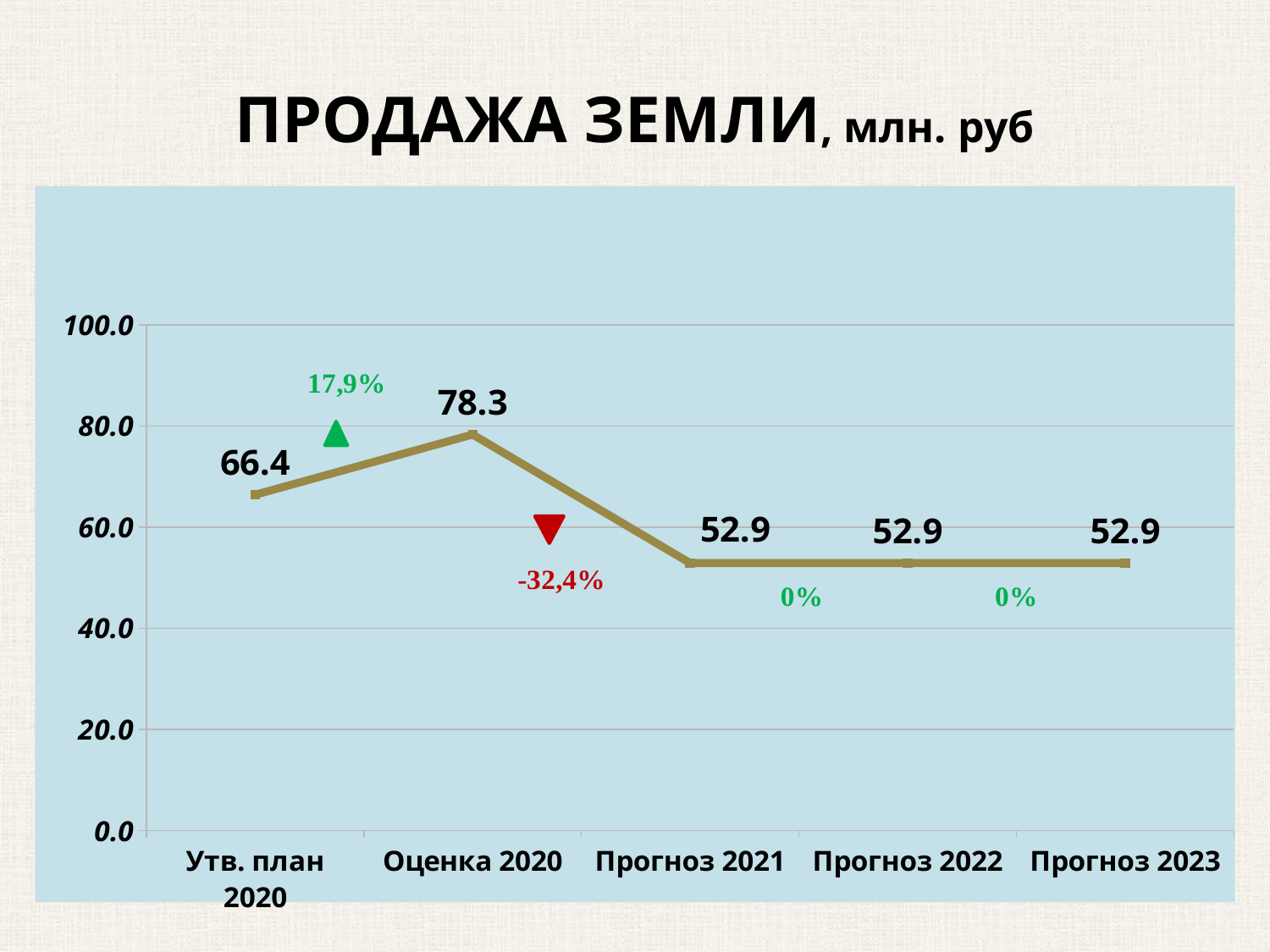
What is the value for Оценка 2020? 78.3 What is the value for Утв. план 2020? 66.4 What is the difference between the values for Оценка 2020 and Утв. план 2020? 11.9 Which is larger, the value for Утв. план 2020 or the value for Прогноз 2022? Утв. план 2020 What kind of chart is shown on the slide? line chart Do the values rise or fall from Оценка 2020 to Прогноз 2021? fall Which category has the highest value? Оценка 2020 What percentage change is shown between Оценка 2020 and Прогноз 2021? -32,4% How many categories are shown on the x axis? 5 Is the value for Оценка 2020 greater or less than 80? less What is the value for Прогноз 2023? 52.9 What is the difference between the values for Оценка 2020 and Прогноз 2021? 25.4